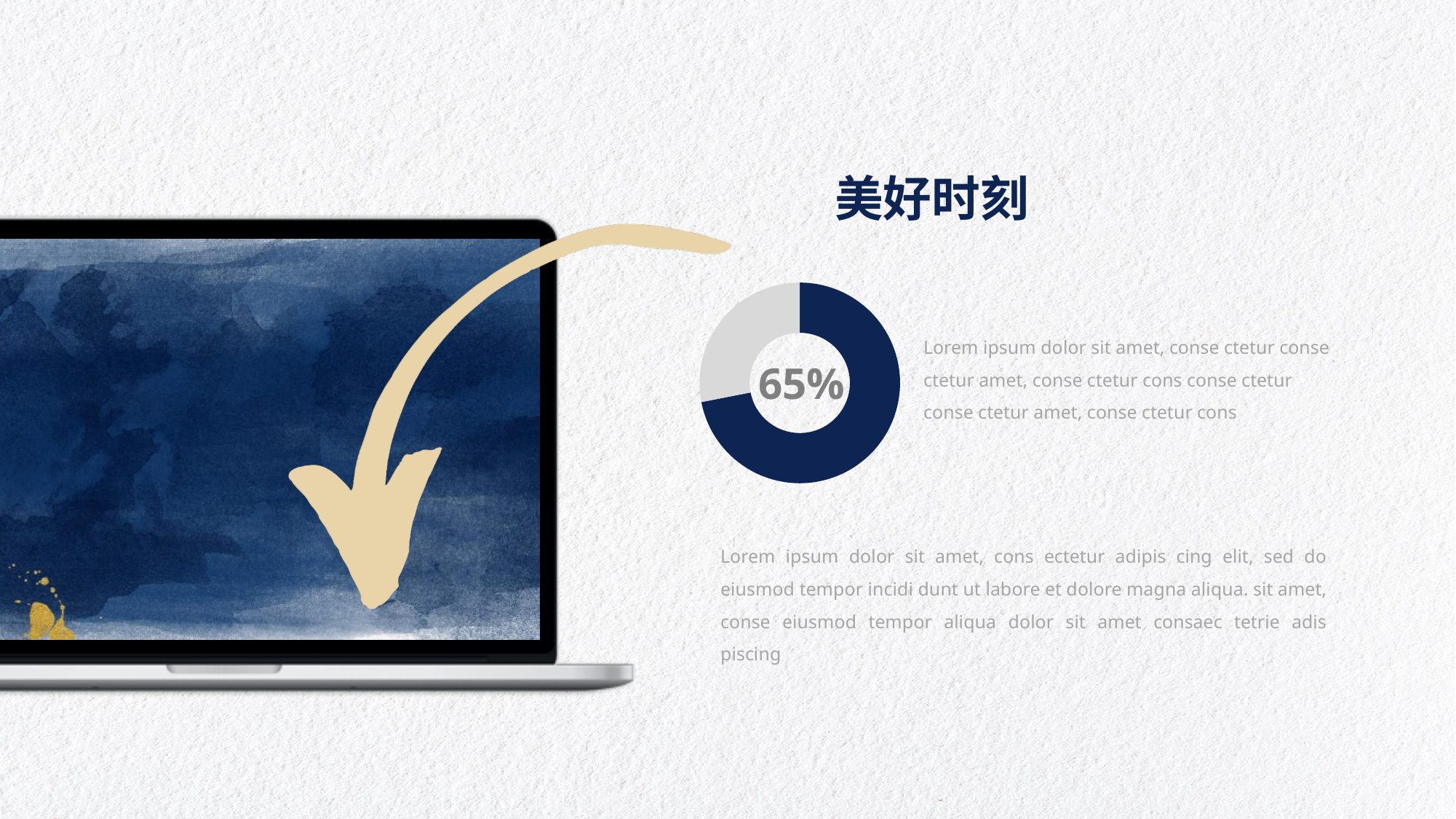
What kind of chart is shown on the slide? Donut (pie) chart What percentage is printed in the centre of the donut chart? 65% Is the dark blue segment of the donut chart greater or less than 50% of the ring? greater What colour is the larger segment of the donut chart? Dark blue How many segments does the donut chart have? 2 What is the heading printed above the donut chart? 美好时刻 Which segment of the donut chart is larger, the dark blue one or the grey one? The dark blue one